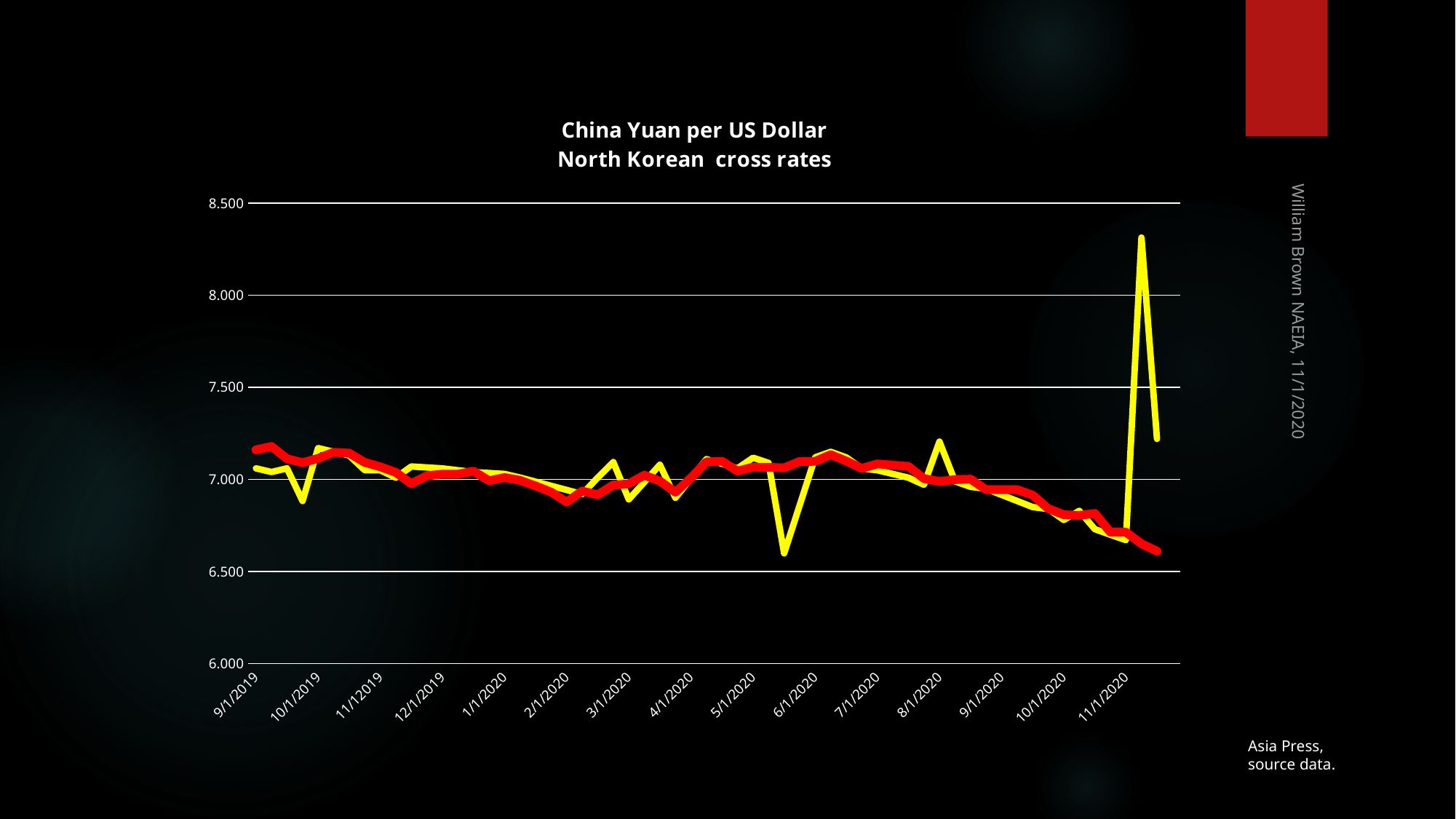
What colours are the two lines on the chart? yellow and red How many date labels are shown on the x axis? 15 How many lines are plotted on the chart? 2 Around which x-axis date does the yellow line reach its highest value? after 11/1/2020 Does the red line overall rise or fall from 9/1/2019 to the end of the series? fall What kind of chart is shown on the slide? line chart Is the value of the red line at 9/1/2019 greater or less than 7.000? greater Is the peak of the yellow line after 11/1/2020 greater or less than 8.000? greater What is the title of the chart? China Yuan per US Dollar North Korean cross rates Is the lowest dip of the yellow line between 5/1/2020 and 6/1/2020 greater or less than 7.000? less What is the highest value shown on the y axis? 8.500